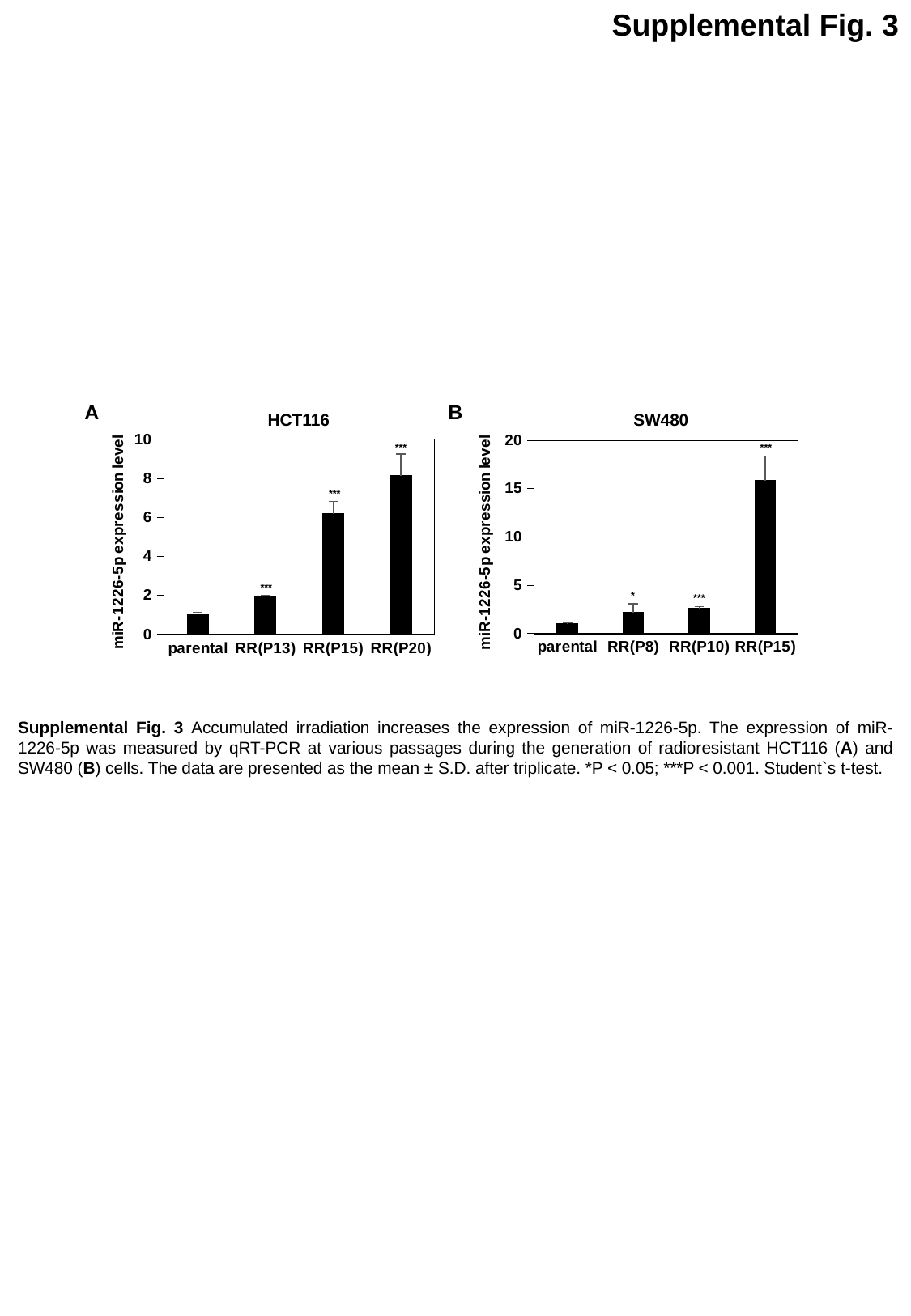
In the HCT116 chart, which is larger, the value for RR(P13) or the value for RR(P15)? RR(P15) How many categories are shown on the x axis of the HCT116 chart? 4 In the HCT116 chart, is the value for RR(P15) greater or less than 4? greater What kind of chart is the HCT116 chart? bar chart What is the y-axis label of the SW480 chart? miR-1226-5p expression level In the SW480 chart, which category has the lowest miR-1226-5p expression level? parental In the SW480 chart, is the value for RR(P15) greater or less than 10? greater In the SW480 chart, do the values rise or fall from parental to RR(P15) along the x axis? rise In the HCT116 chart, which category has the lowest miR-1226-5p expression level? parental In the SW480 chart, which category has the highest miR-1226-5p expression level? RR(P15) How many categories are shown on the x axis of the SW480 chart? 4 In the HCT116 chart, which category has the highest miR-1226-5p expression level? RR(P20)